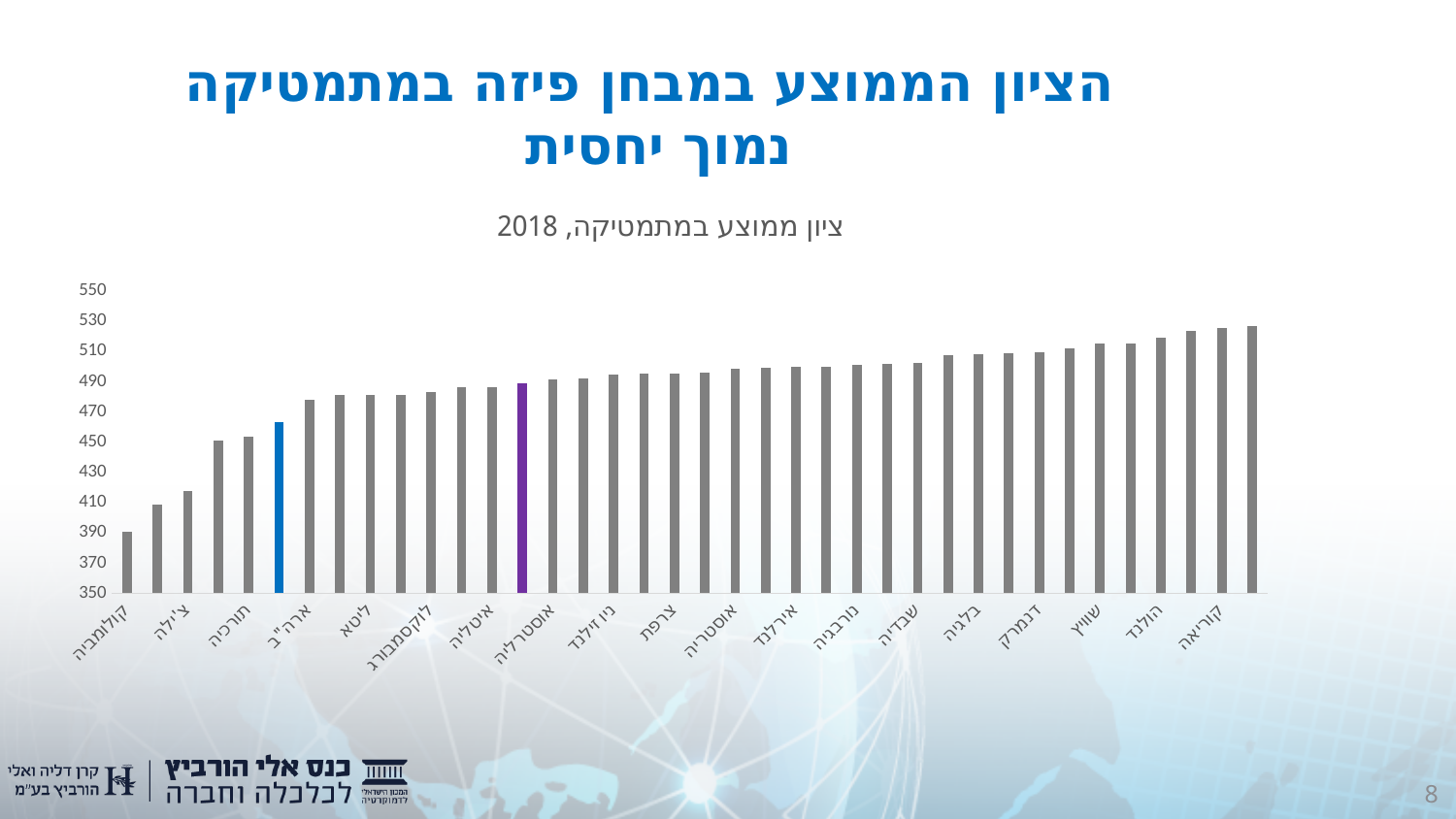
Is the value of the blue bar greater or less than 490? less Which labeled country has the lowest bar in the chart? קולומביה Which year's data does the chart show? 2018 What is the title of the chart? ציון ממוצע במתמטיקה, 2018 Is the value of the purple bar greater or less than 470? greater Which is larger, the leftmost bar or the rightmost bar? The rightmost bar What is the lowest value shown on the vertical axis? 350 Do the bar values rise or fall from left to right along the x axis? Rise What kind of chart is shown on the slide? Bar chart Is the value of the rightmost bar greater or less than 510? greater